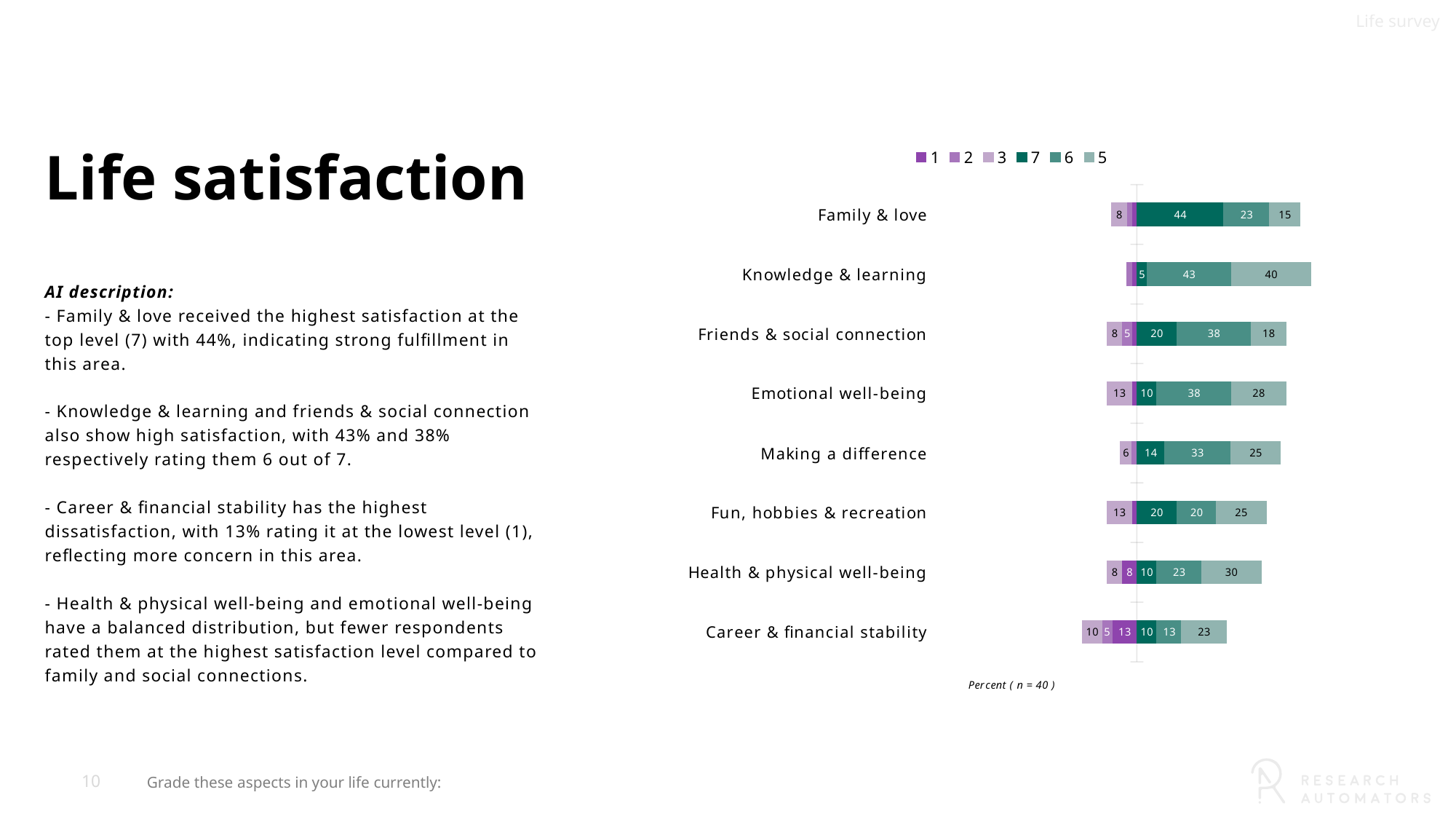
What percentage of respondents rated Family & love at level 7? 44 What percentage of respondents rated Knowledge & learning at level 6? 43 How many aspects (categories) are shown in the chart? 8 Which has a larger level 5 percentage: Emotional well-being or Making a difference? Emotional well-being Which aspect has the lowest percentage of respondents rating it at level 7? Knowledge & learning What is the difference between the level 7 percentage for Family & love and the level 7 percentage for Knowledge & learning? 39 What percentage of respondents rated Career & financial stability at level 1? 13 Which aspect has the highest percentage of respondents rating it at level 7? Family & love What percentage of respondents rated Health & physical well-being at level 5? 30 What sample size is stated in the note below the chart? n = 40 How many series does the legend list? 6 What kind of chart is shown on the slide? Stacked bar chart